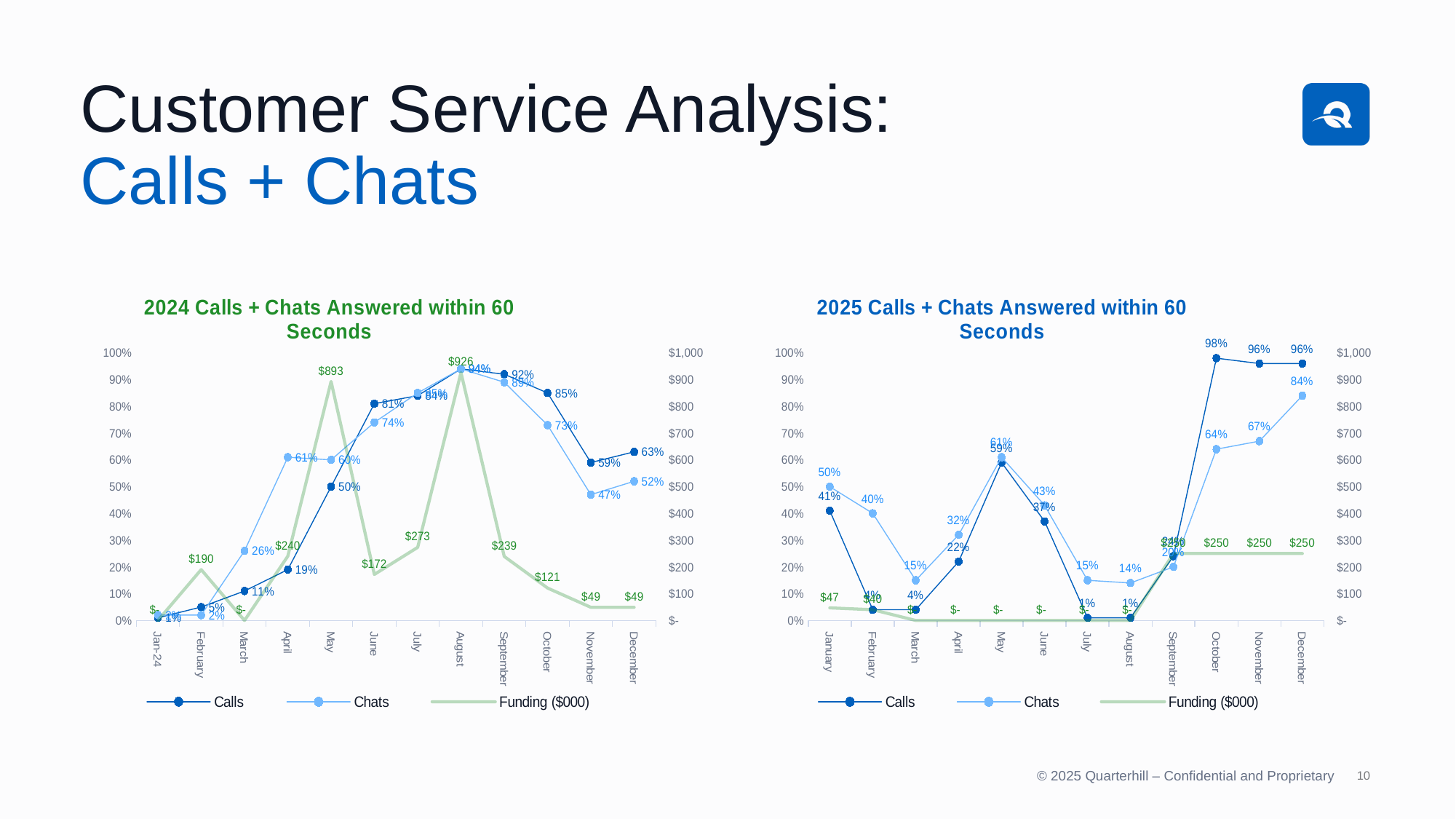
In the 2024 Calls + Chats Answered within 60 Seconds chart, what is the Calls value for June? 81% In the 2025 Calls + Chats Answered within 60 Seconds chart, what is the Funding ($000) value for September? $250 How many series does the legend of the 2025 Calls + Chats Answered within 60 Seconds chart list? 3 In the 2024 Calls + Chats Answered within 60 Seconds chart, what is the difference between the Calls value for October (85%) and the Chats value for October (73%)? 12% In the 2024 Calls + Chats Answered within 60 Seconds chart, what is the Funding ($000) value for May? $893 In the 2025 Calls + Chats Answered within 60 Seconds chart, what is the Chats value for December? 84% What kind of chart is the 2025 Calls + Chats Answered within 60 Seconds chart? Line chart In the 2024 Calls + Chats Answered within 60 Seconds chart, which is larger in November: the Calls value or the Chats value? Calls How many months are shown on the x axis of the 2024 Calls + Chats Answered within 60 Seconds chart? 12 In the 2025 Calls + Chats Answered within 60 Seconds chart, what is the Calls value for October? 98% In the 2024 Calls + Chats Answered within 60 Seconds chart, which month has the highest Funding ($000) value? August In the 2025 Calls + Chats Answered within 60 Seconds chart, which month has the lowest Chats value? August